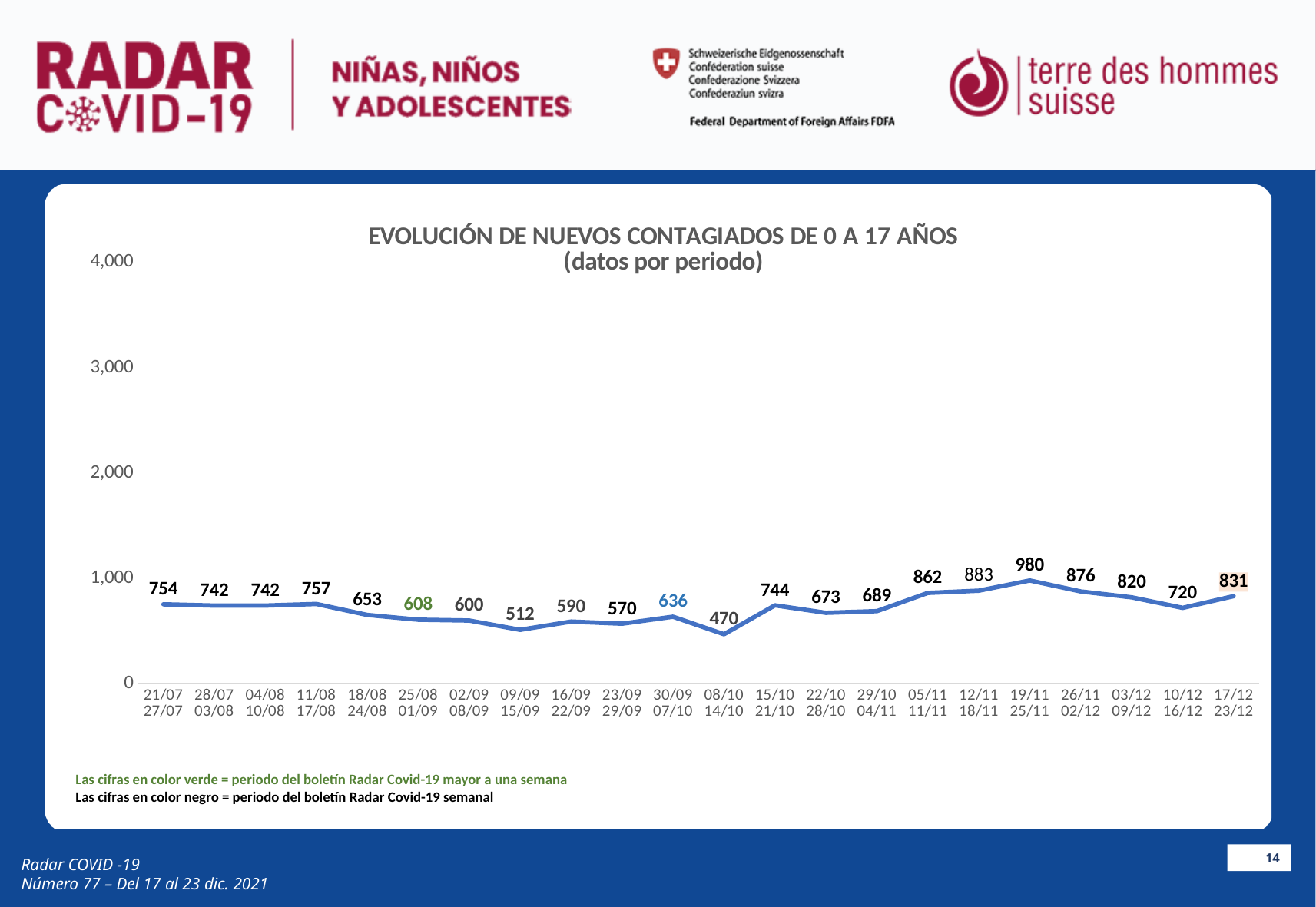
What is the value for the period 08/10–14/10? 470 What is the value for the period 17/12–23/12? 831 Which period has the highest value? 19/11–25/11 How many periods are plotted on the chart? 22 What is the difference between the values for 19/11–25/11 and 08/10–14/10? 510 Which period has the lowest value? 08/10–14/10 What is the value for the period 25/08–01/09? 608 What is the title of the chart? EVOLUCIÓN DE NUEVOS CONTAGIADOS DE 0 A 17 AÑOS (datos por periodo) Which is larger, the value for 12/11–18/11 or the value for 26/11–02/12? 12/11–18/11 What type of chart is shown on the slide? Line chart Is the value for 19/11–25/11 greater or less than 1,000? less Do the values rise or fall from 10/12–16/12 to 17/12–23/12? Rise